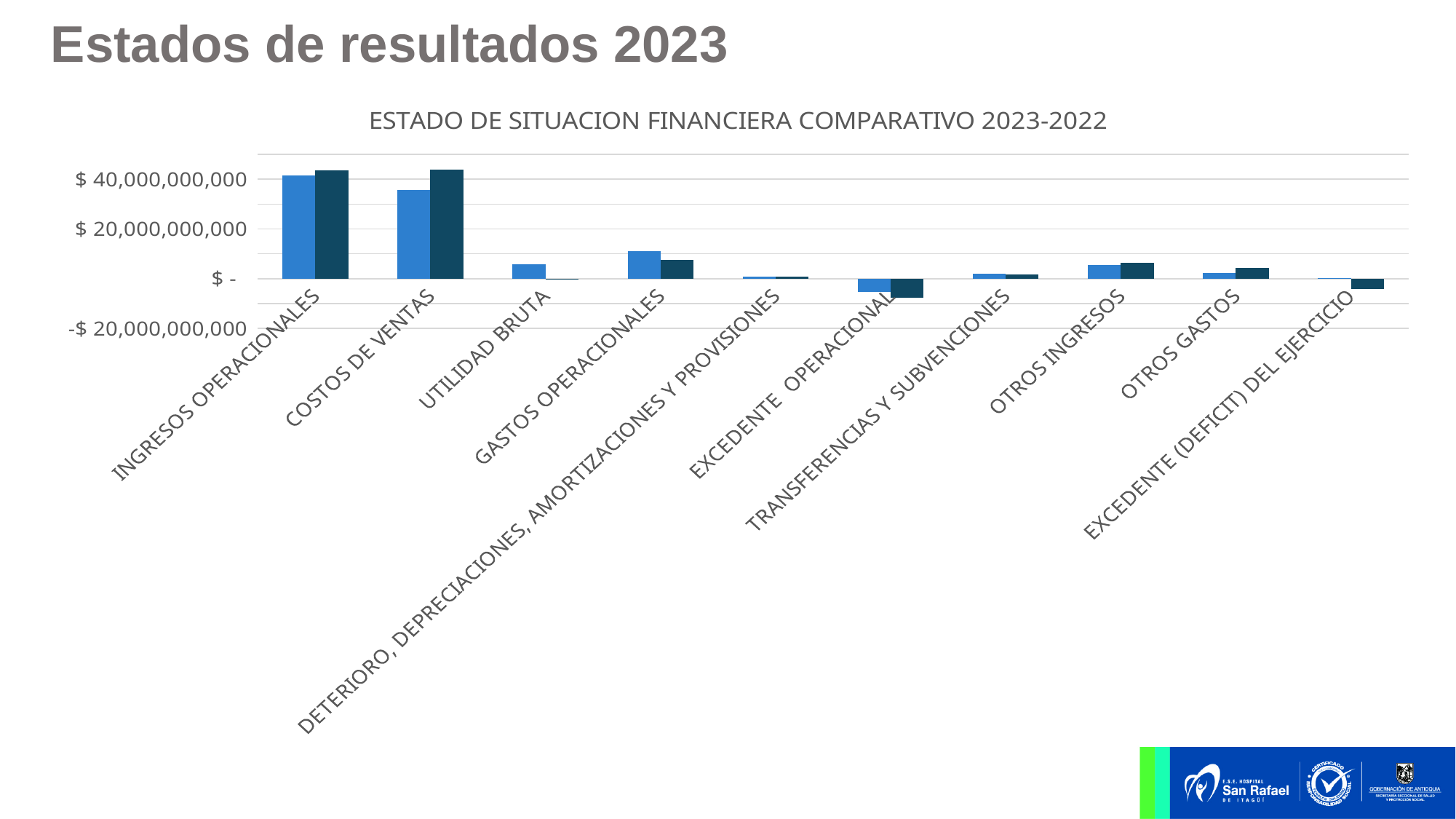
Which category has the lowest lighter blue bar? EXCEDENTE OPERACIONAL Is the lighter blue bar for UTILIDAD BRUTA greater or less than $ 20,000,000,000? less Is the lighter blue bar for INGRESOS OPERACIONALES greater or less than $ 20,000,000,000? greater Is the lighter blue bar for COSTOS DE VENTAS greater or less than $ 40,000,000,000? less Which is larger, the lighter blue bar for UTILIDAD BRUTA or the lighter blue bar for GASTOS OPERACIONALES? GASTOS OPERACIONALES What is the title of the chart? ESTADO DE SITUACION FINANCIERA COMPARATIVO 2023-2022 Which category has the tallest lighter blue bar? INGRESOS OPERACIONALES What kind of chart is shown on the slide? Bar chart How many bars are plotted for each category in the chart? 2 How many categories are shown on the x axis of the chart? 10 Which category has the lowest dark blue bar? EXCEDENTE OPERACIONAL